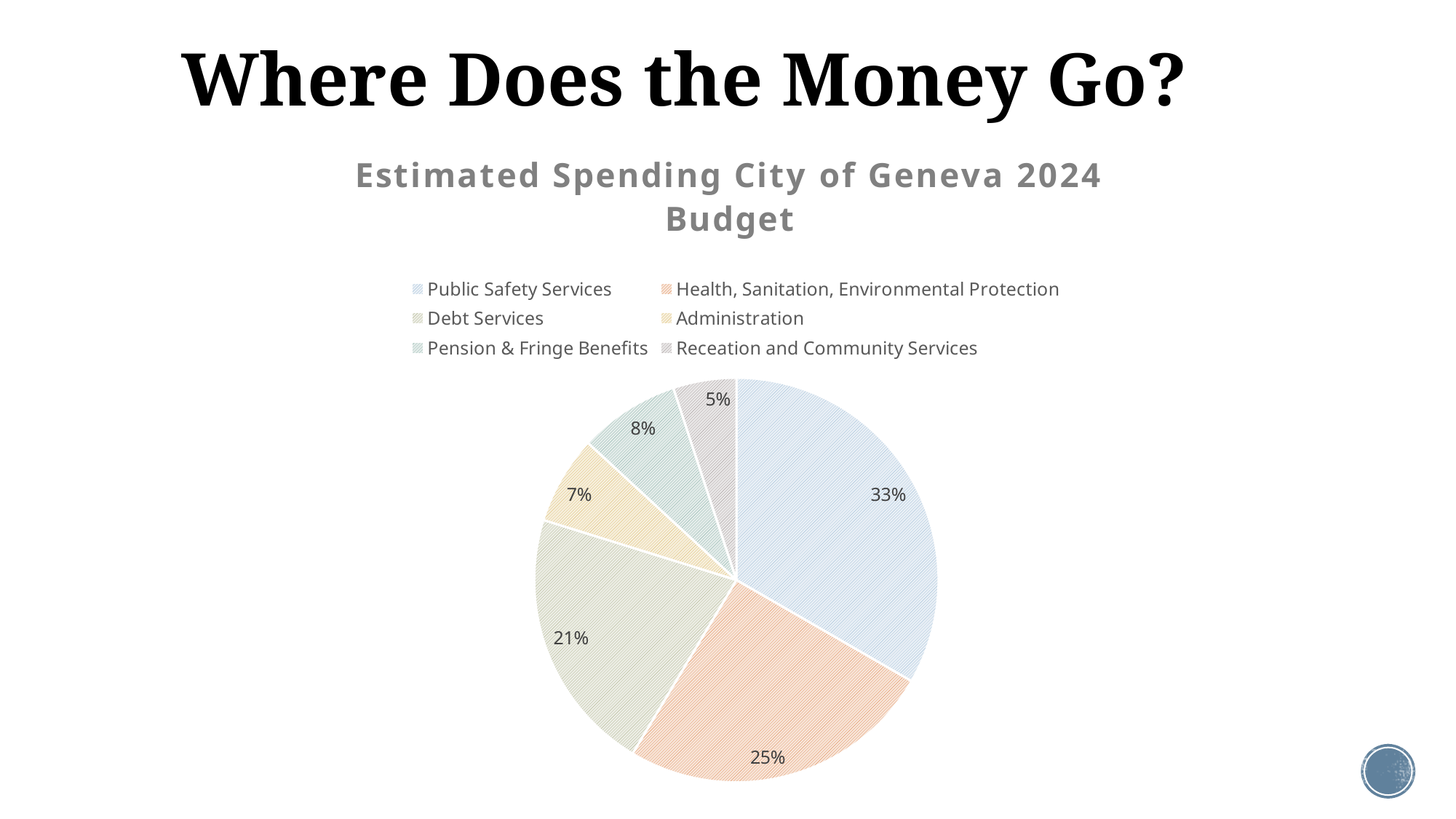
What share of the budget goes to Pension & Fringe Benefits? 8% What is the difference in percentage points between Public Safety Services and Debt Services? 12 What share of the budget goes to Administration? 7% What share of the budget goes to Health, Sanitation, Environmental Protection? 25% How many categories does the legend list? 6 Which category has the smallest share of the budget? Receation and Community Services What is the title of the chart? Estimated Spending City of Geneva 2024 Budget Which is larger, the share for Pension & Fringe Benefits or the share for Administration? Pension & Fringe Benefits Which category has the largest share of the budget? Public Safety Services What kind of chart is shown on the slide? Pie chart